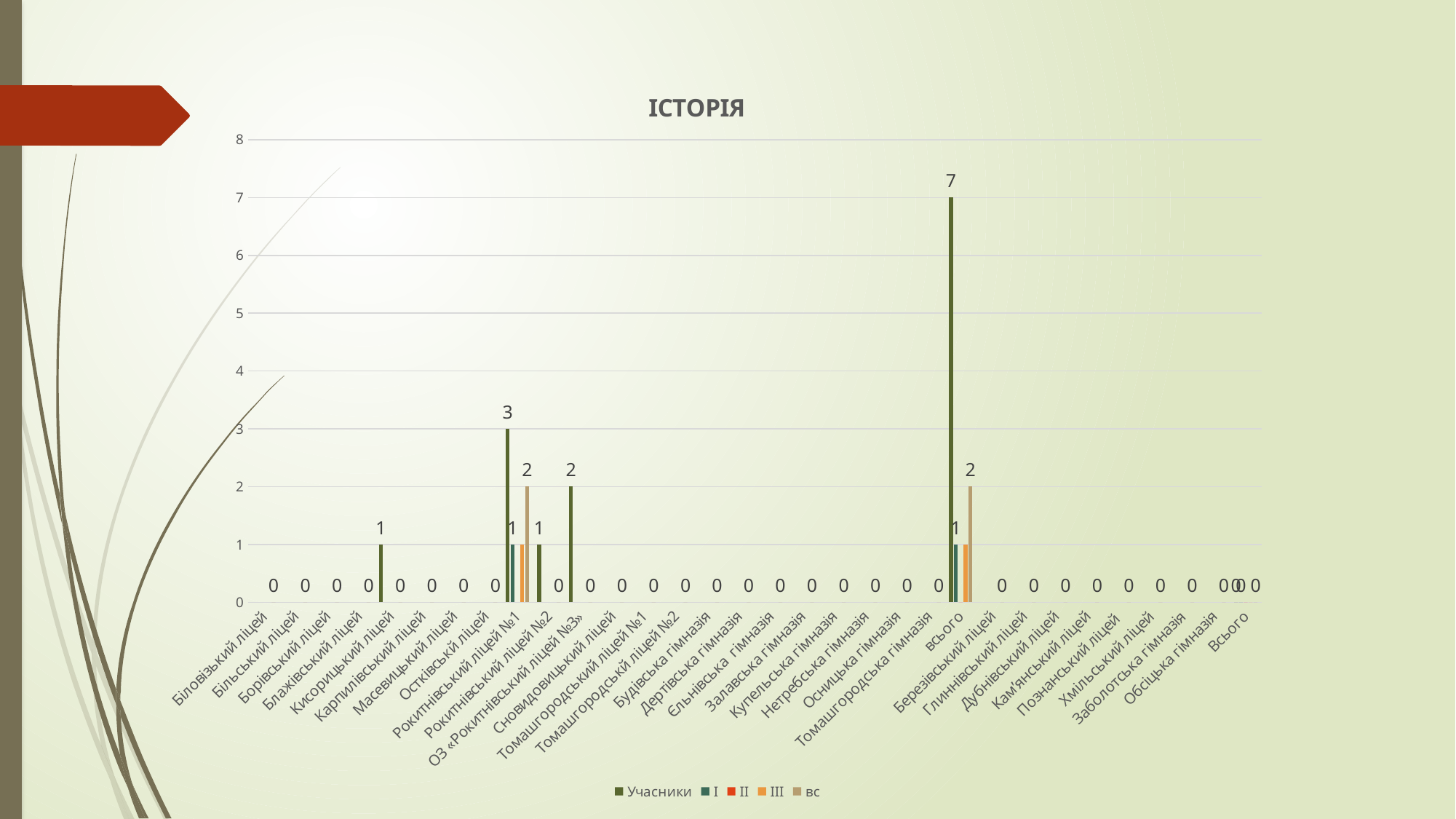
Which has a larger Учасники value, Рокитнівський ліцей №1 or Рокитнівський ліцей №2? Рокитнівський ліцей №1 How many series does the legend list? 5 What is the title of the chart? ІСТОРІЯ What kind of chart is shown on the slide? bar chart What is the difference between the Учасники values for всього and Рокитнівський ліцей №1? 4 What is the вс value for Рокитнівський ліцей №1? 2 Which category has the highest Учасники value? всього What is the Учасники value for Рокитнівський ліцей №1? 3 What is the Учасники value for Кисорицький ліцей? 1 What is the Учасники value for всього? 7 What is the Учасники value for ОЗ «Рокитнівський ліцей №3»? 2